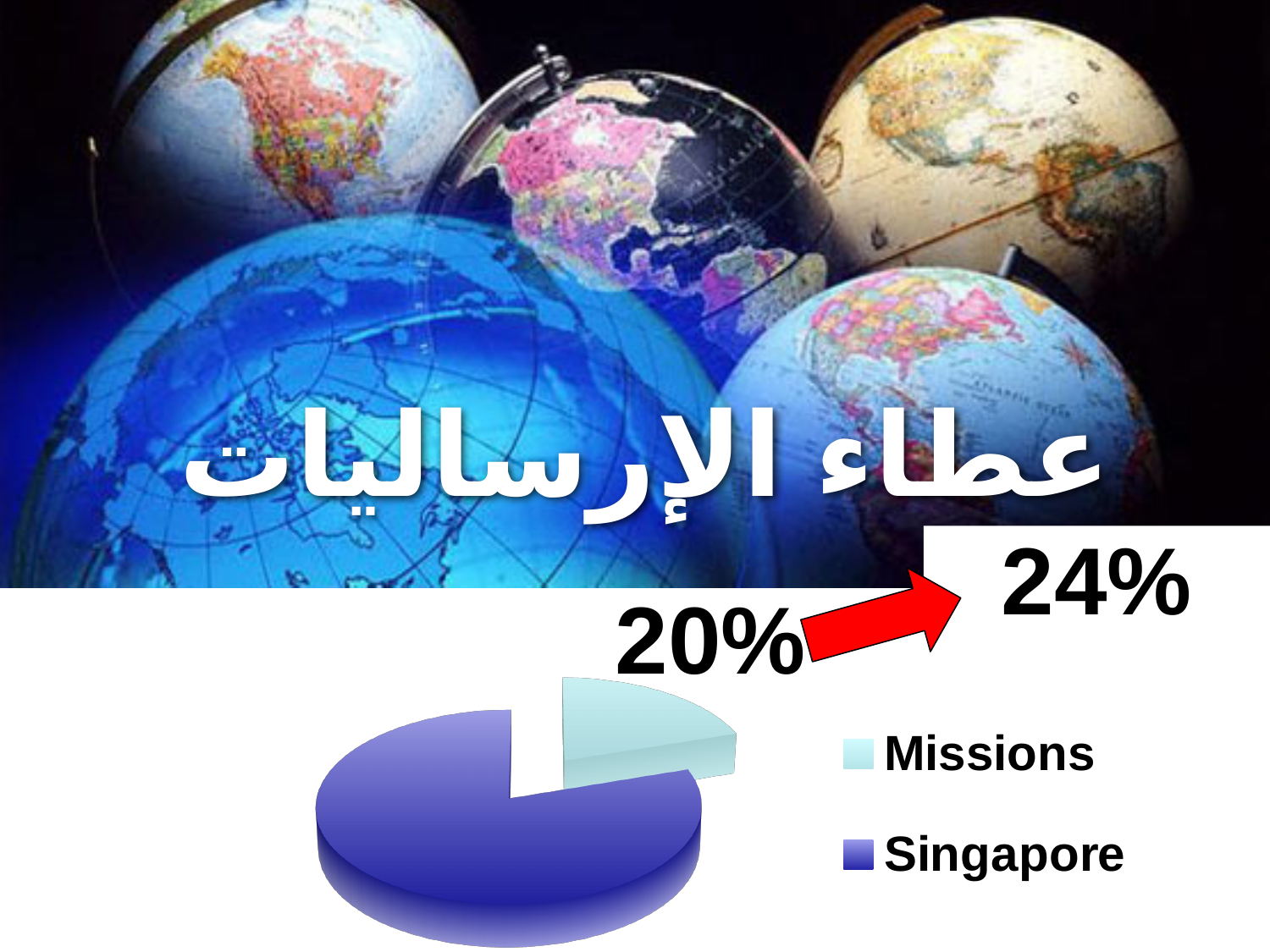
Which is larger in the pie chart, the Missions slice or the Singapore slice? Singapore How many slices does the pie chart have? 2 Is the Missions slice of the pie chart greater or less than 50% of the pie? less What are the two legend entries of the pie chart? Missions and Singapore What kind of chart is shown on the slide? pie chart How many entries does the legend of the pie chart list? 2 Is the Singapore slice of the pie chart greater or less than 50% of the pie? greater What percentage is labelled next to the Missions slice of the pie chart? 20% Which slice of the pie chart is the smallest? Missions Which slice of the pie chart is the largest? Singapore What percentage does the red arrow on the slide point to? 24%